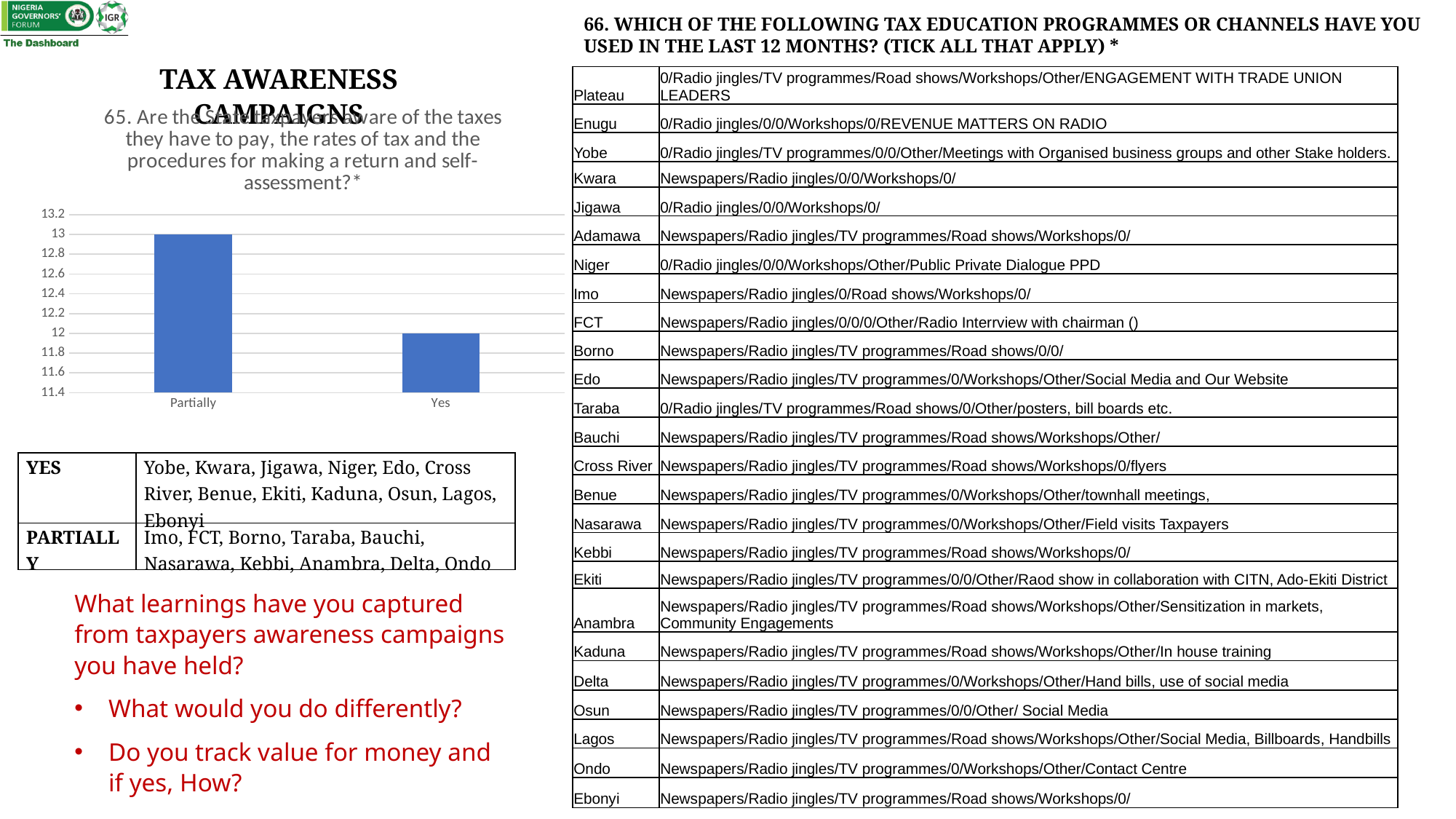
Is the value for Yes greater or less than 12.4? less What is the value for Partially? 13 Which category has the highest value? Partially Which is larger, the value for Partially or the value for Yes? Partially How many categories are shown on the x axis of the chart? 2 What kind of chart is shown on the slide? bar chart What colour are the bars in the chart? blue Do the values rise or fall from Partially to Yes along the x axis? fall What is the value for Yes? 12 Is the value for Partially greater or less than 12.6? greater Which category has the lowest value? Yes What is the difference between the values for Partially and Yes? 1